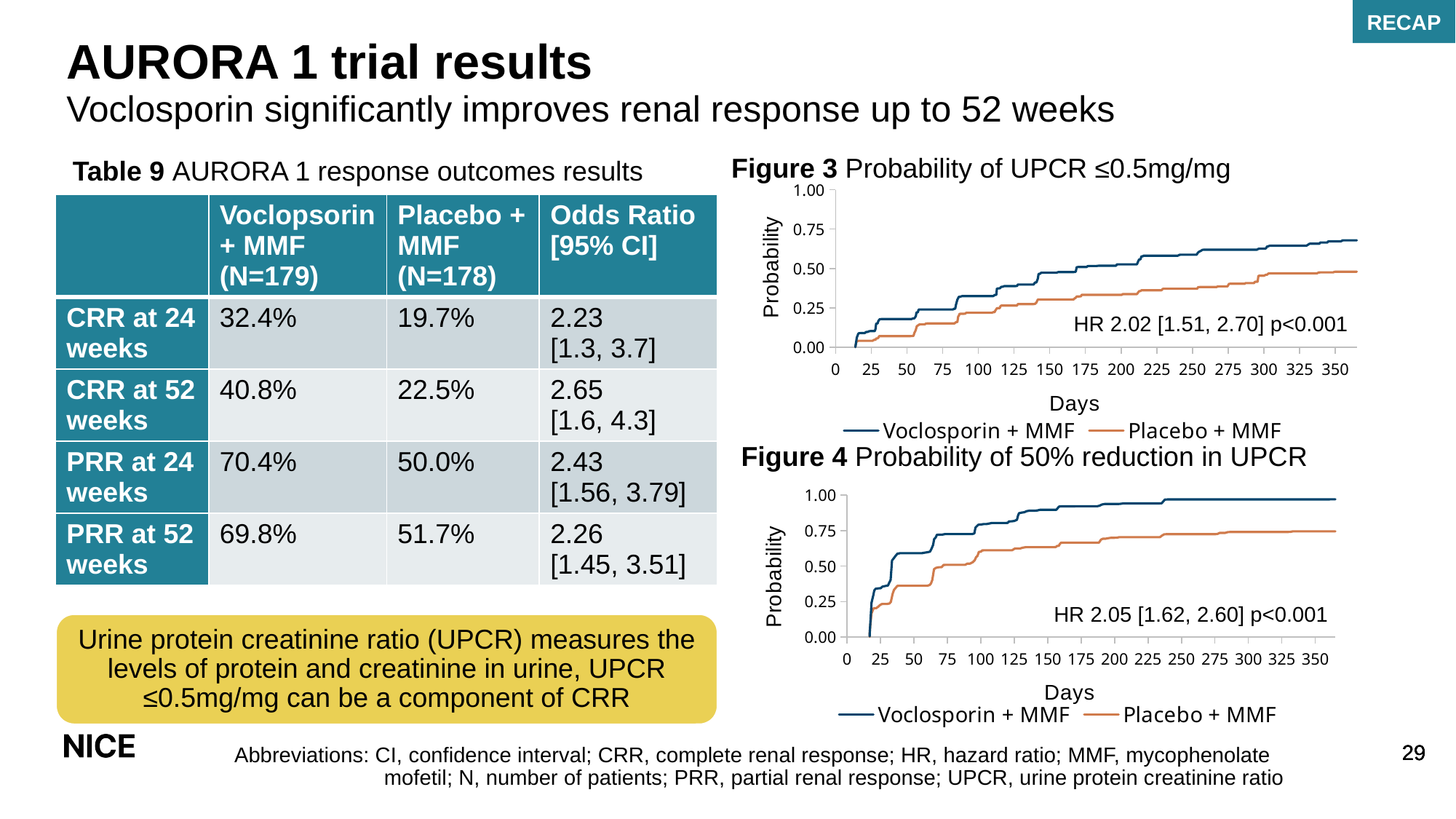
In Figure 3 (Probability of UPCR ≤0.5mg/mg), is the probability for Placebo + MMF at 350 days greater or less than 0.50? less How many series does the legend of Figure 4 (Probability of 50% reduction in UPCR) list? 2 In Figure 4 (Probability of 50% reduction in UPCR), is the probability for Placebo + MMF at 350 days greater or less than 0.50? greater In Figure 4 (Probability of 50% reduction in UPCR), is the probability for Voclosporin + MMF at 350 days greater or less than 0.75? greater What is the x-axis label of Figure 4 (Probability of 50% reduction in UPCR)? Days What hazard ratio is printed on Figure 3 (Probability of UPCR ≤0.5mg/mg)? HR 2.02 [1.51, 2.70] p<0.001 What kind of chart is Figure 3 (Probability of UPCR ≤0.5mg/mg)? Line chart In Figure 4 (Probability of 50% reduction in UPCR), which series is lower at 350 days? Placebo + MMF In Figure 4 (Probability of 50% reduction in UPCR), does the Voclosporin + MMF curve rise or fall as days increase? Rise In Figure 3 (Probability of UPCR ≤0.5mg/mg), which series is higher at 350 days, Voclosporin + MMF or Placebo + MMF? Voclosporin + MMF